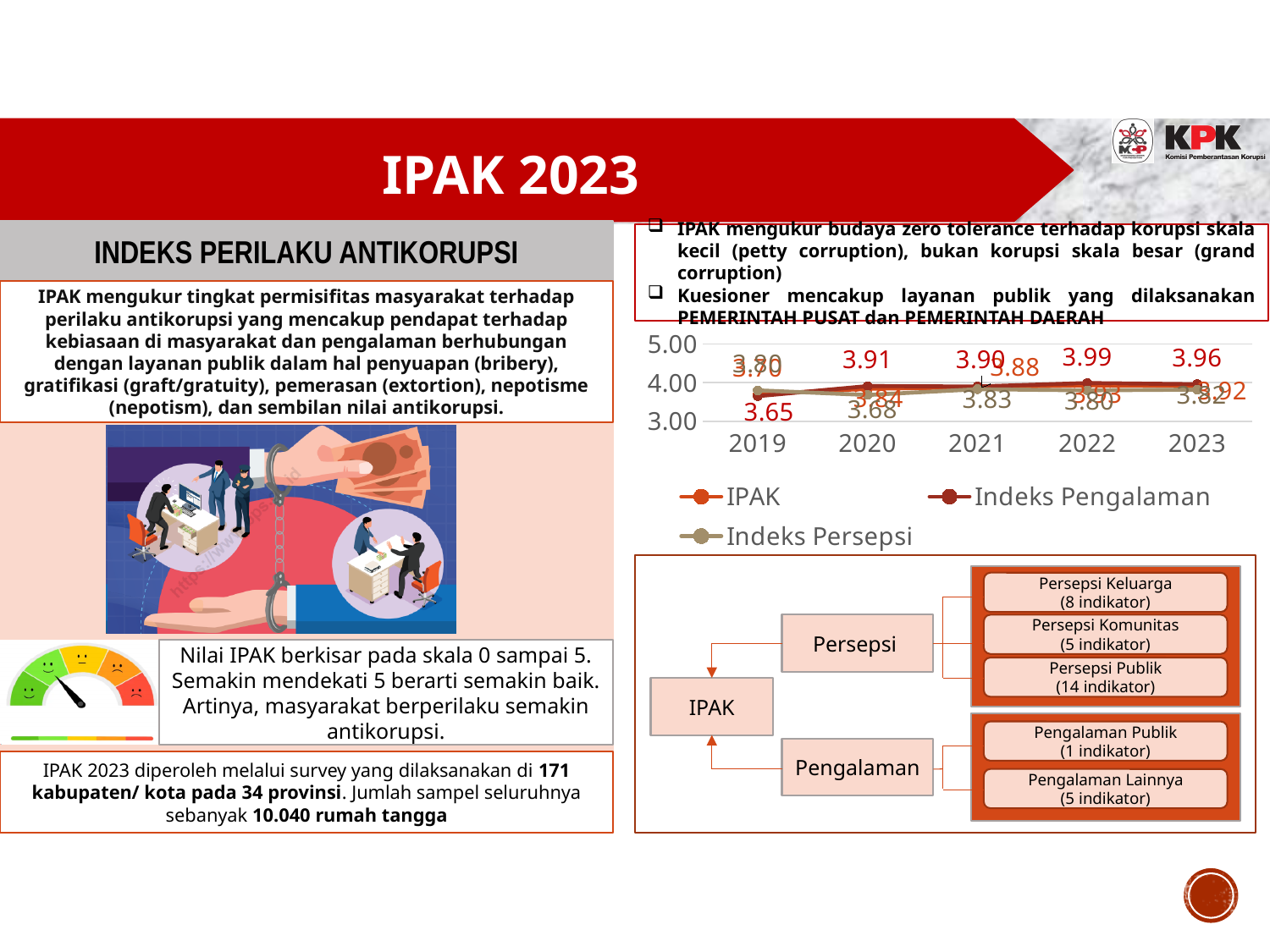
What are the three series named in the legend of the line chart? IPAK, Indeks Pengalaman, Indeks Persepsi How many years are shown on the x axis of the line chart? 5 In the line chart, which year has the higher top data label, 2019 or 2022? 2022 How many series does the legend of the line chart list? 3 What is the highest data label shown for 2020 in the line chart? 3.91 In the line chart, is the lowest value for 2019 greater or less than 3.00? greater In the line chart, is the highest value for 2022 greater or less than 4.00? less What kind of chart is shown on the right side of the slide, below the text box about petty corruption? Line chart What is the lowest data label shown for 2019 in the line chart? 3.65 Which year is the first on the x axis of the line chart? 2019 What is the highest data label shown for 2022 in the line chart? 3.99 What is the highest data label shown for 2023 in the line chart? 3.96